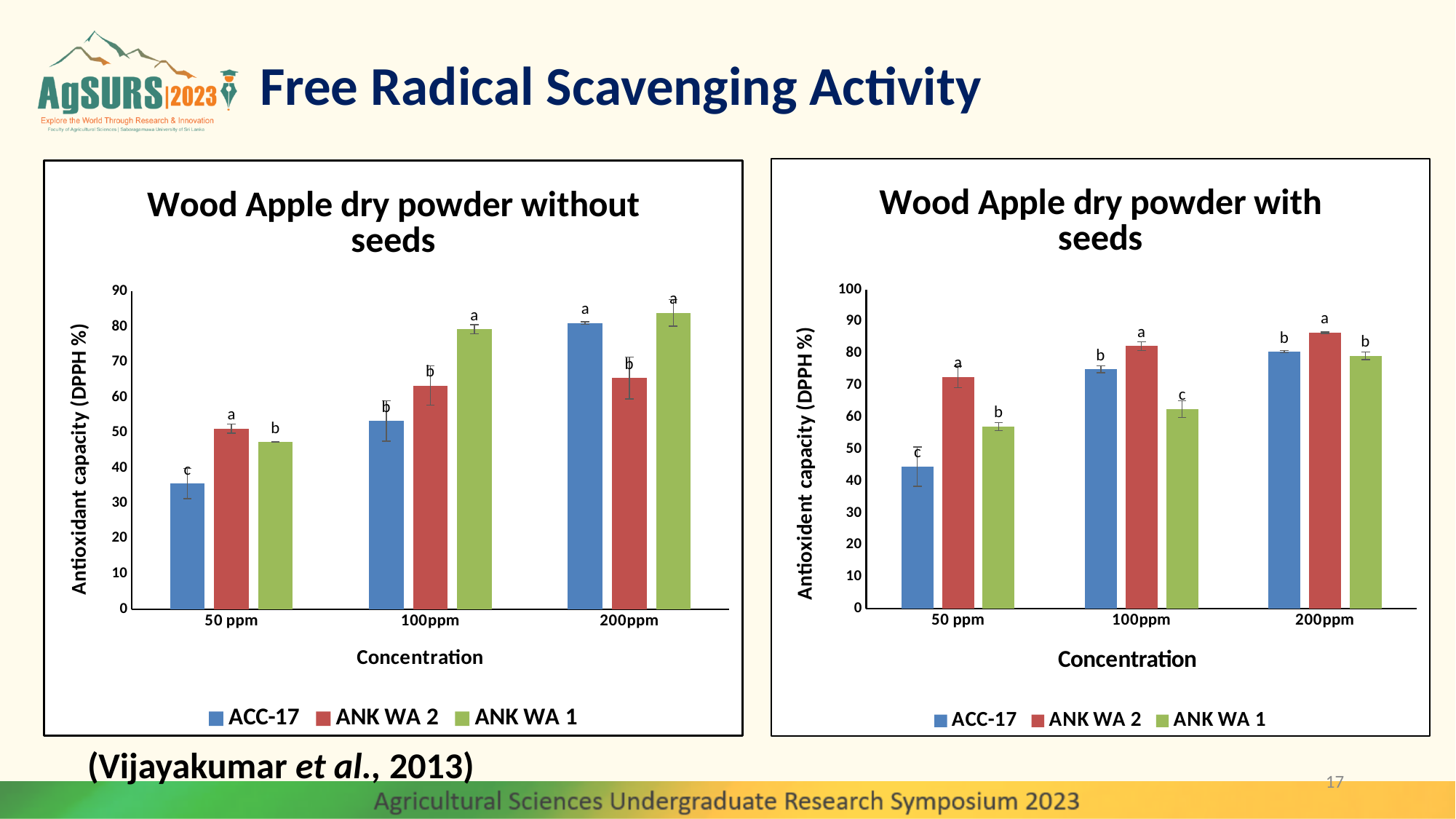
In the 'Wood Apple dry powder without seeds' chart, how many concentration categories are shown on the x axis? 3 In the 'Wood Apple dry powder with seeds' chart, which series has the highest value at 50 ppm? ANK WA 2 In the 'Wood Apple dry powder without seeds' chart, is the value for ANK WA 1 at 100ppm greater or less than 70? greater In the 'Wood Apple dry powder without seeds' chart, is the value for ACC-17 at 50 ppm greater or less than 40? less In the 'Wood Apple dry powder without seeds' chart, how many series does the legend list? 3 What is the y-axis label of the 'Wood Apple dry powder with seeds' chart? Antioxident capacity (DPPH %) In the 'Wood Apple dry powder without seeds' chart, do the ACC-17 values rise or fall as concentration increases from 50 ppm to 200ppm? rise What type of chart is the 'Wood Apple dry powder without seeds' chart? bar chart In the 'Wood Apple dry powder without seeds' chart, at 100ppm, which is larger: ANK WA 1 or ANK WA 2? ANK WA 1 In the 'Wood Apple dry powder with seeds' chart, is the value for ACC-17 at 50 ppm greater or less than 50? less In the 'Wood Apple dry powder without seeds' chart, which series has the lowest value at 50 ppm? ACC-17 In the 'Wood Apple dry powder with seeds' chart, at 100ppm, which is larger: ACC-17 or ANK WA 1? ACC-17